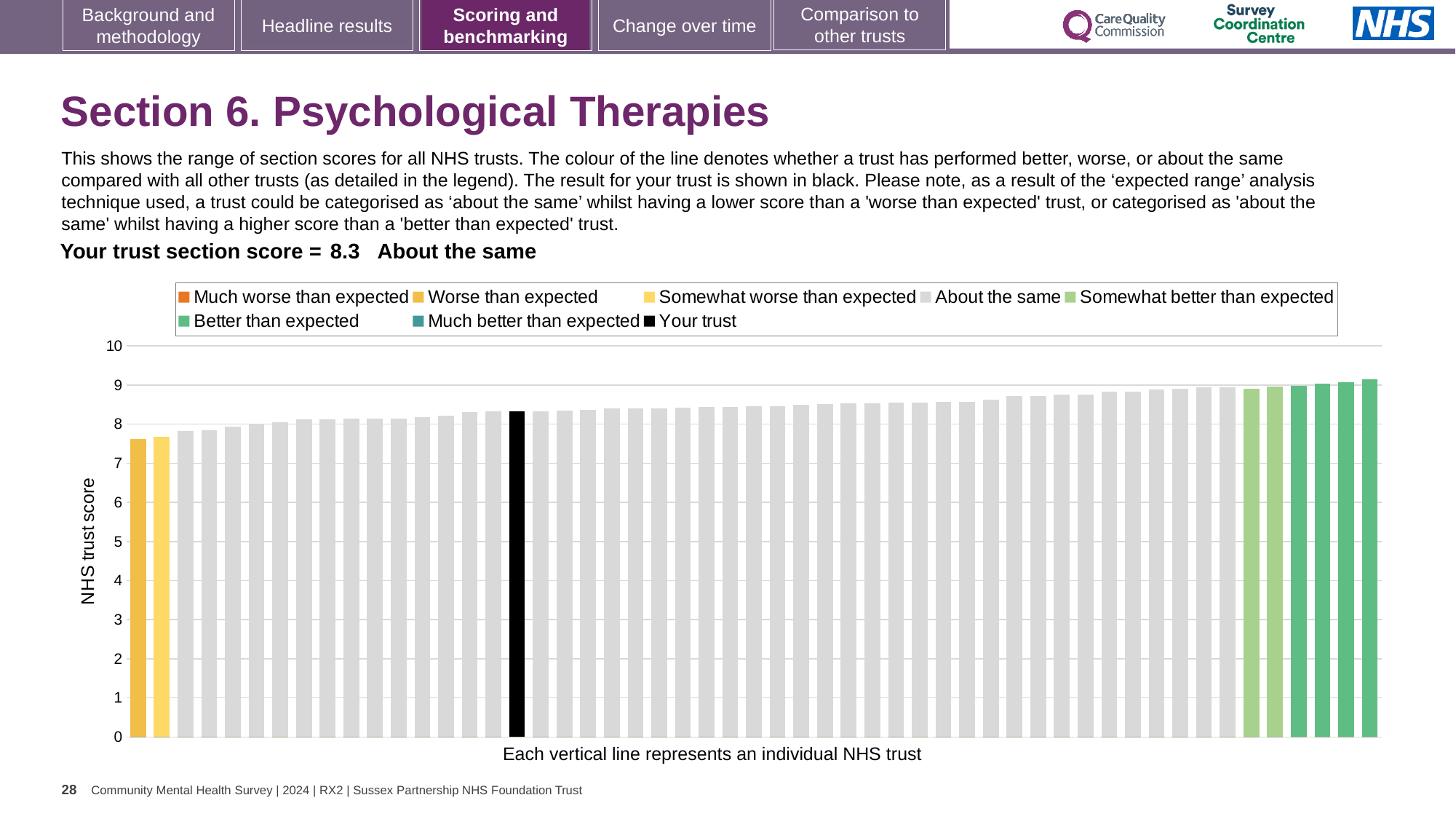
What colour is the bar representing your trust? black Is the value of the rightmost (highest) bar greater or less than 9? greater What kind of chart is shown on the slide? bar chart Is the value of the black 'Your trust' bar greater or less than 8? greater How many entries does the chart legend list? 8 What is the label of the vertical axis? NHS trust score What is the highest value shown on the vertical axis? 10 Is the value of the leftmost (lowest) bar greater or less than 7? greater Which category is your trust's section score placed in? About the same What is the section score for your trust shown on the slide? 8.3 Do the bar values rise or fall from left to right along the x axis? rise